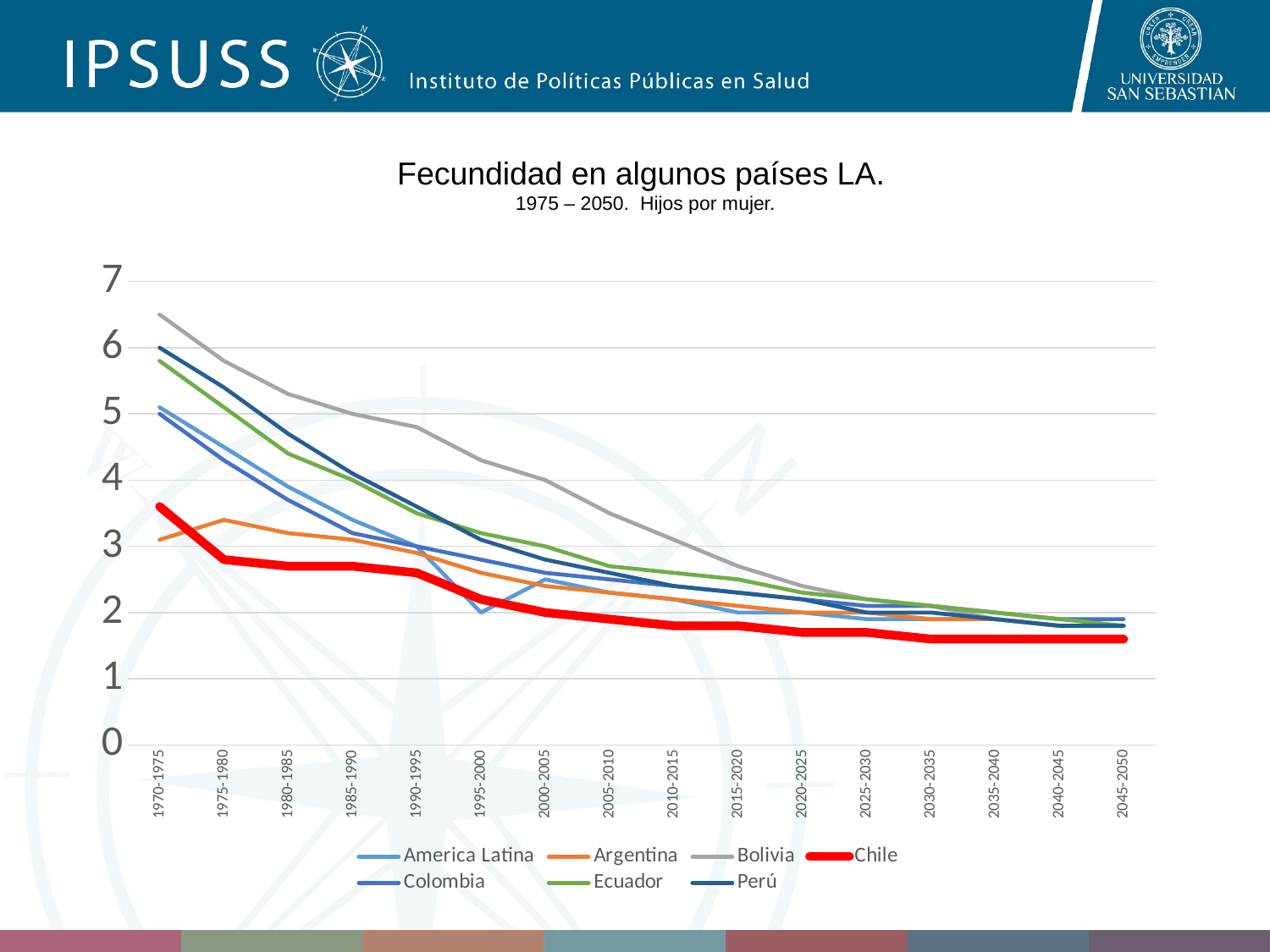
Is the value for Chile in 1970-1975 greater or less than 4? less Which series has the lowest value in 1970-1975? Argentina Is the value for Ecuador in 1970-1975 greater or less than 5? greater Which country has the highest fertility value in 1970-1975? Bolivia Does the Bolivia line rise or fall from 1970-1975 to 2045-2050? fall Which country has the lowest fertility value in 2045-2050? Chile Is the value for Chile in 2045-2050 greater or less than 2? less How many series does the legend list? 7 In 1970-1975, which is larger: the value for Bolivia or the value for Chile? Bolivia How many time periods are shown on the x axis? 16 What kind of chart is shown on the slide? line chart